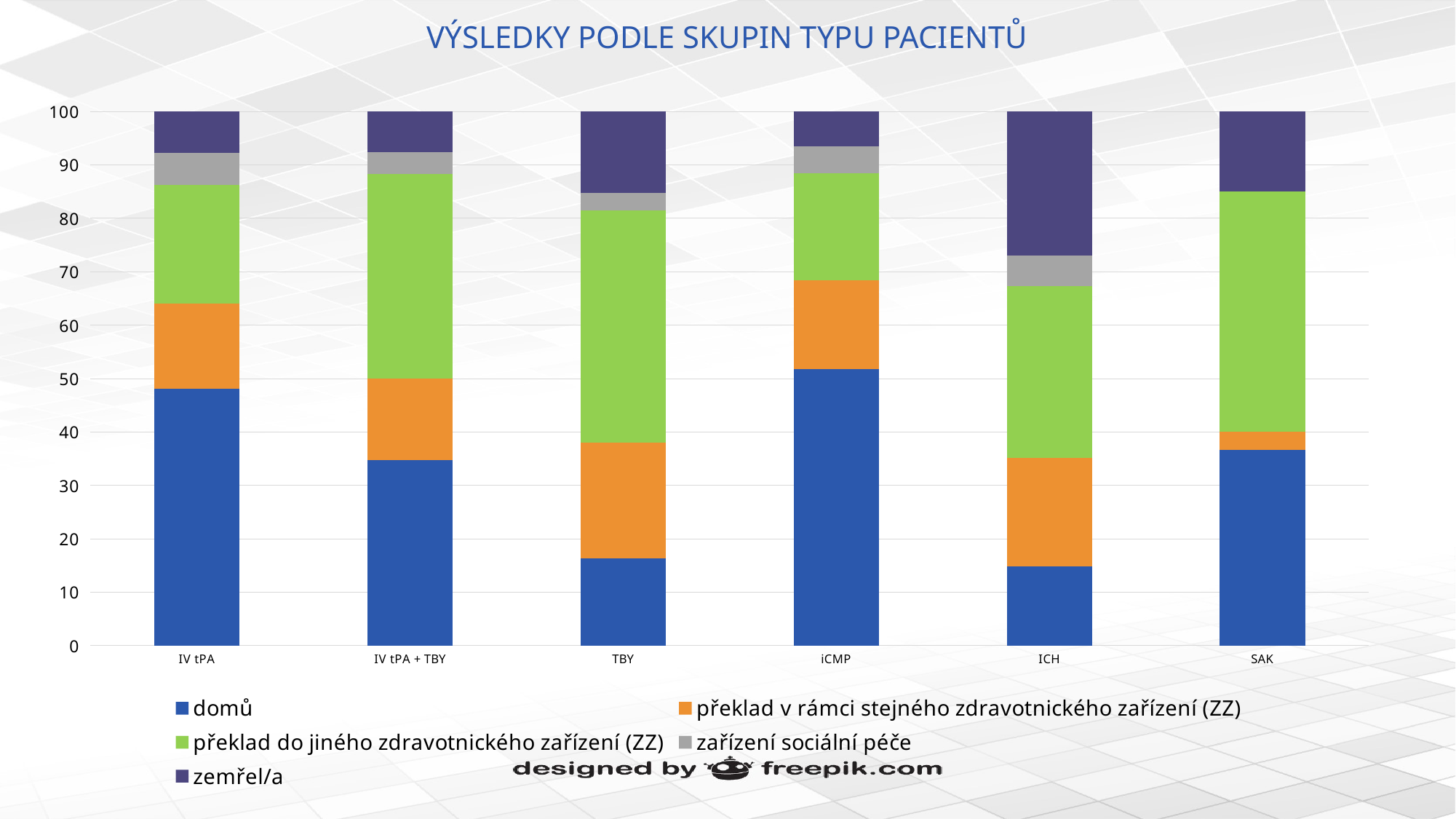
Which has a larger 'domů' share, IV tPA or IV tPA + TBY? IV tPA What is the title of the chart? VÝSLEDKY PODLE SKUPIN TYPU PACIENTŮ Which patient group has the largest 'zemřel/a' share? ICH Is the 'domů' value for TBY greater or less than 20? less What kind of chart is shown on the slide? stacked bar chart How many series does the legend list? 5 What is the total height of the stacked bar for IV tPA? 100 How many patient groups (categories) are shown on the x axis? 6 Which has a larger 'zemřel/a' share, ICH or SAK? ICH Which patient group has the largest 'domů' share? iCMP Which colour represents the series 'domů' in the chart? blue Is the 'domů' value for IV tPA greater or less than 40? greater